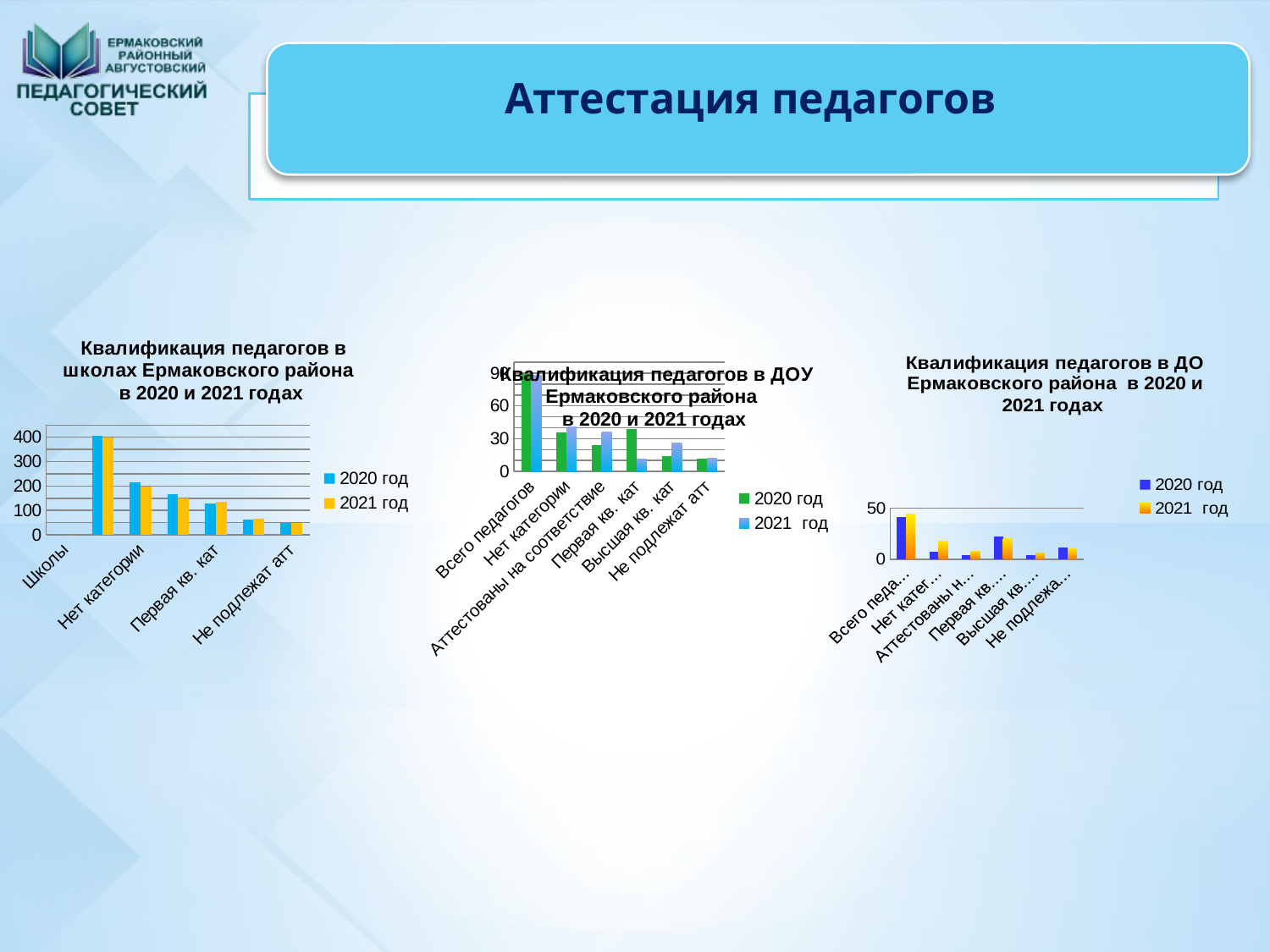
In the left chart (Квалификация педагогов в школах), do the values rise or fall moving from left to right along the x axis? fall In the left chart (Квалификация педагогов в школах), how many series does the legend list? 2 In the middle chart (Квалификация педагогов в ДОУ), which category has the highest values? Всего педагогов In the right chart (Квалификация педагогов в ДО), how many series does the legend list? 2 In the middle chart (Квалификация педагогов в ДОУ), is the 2020 год value for Всего педагогов greater or less than 60? greater In the middle chart (Квалификация педагогов в ДОУ), what colour represents the 2020 год series? green In the left chart (Квалификация педагогов в школах), is the 2020 год value for Школы greater or less than 300? less In the left chart (Квалификация педагогов в школах), is the 2020 год value for Не подлежат атт greater or less than 100? less In the middle chart (Квалификация педагогов в ДОУ), how many categories are shown on the x axis? 6 In the middle chart (Квалификация педагогов в ДОУ), which is larger for Первая кв. кат: 2020 год or 2021 год? 2020 год What type of chart is the left chart titled 'Квалификация педагогов в школах Ермаковского района в 2020 и 2021 годах'? bar chart